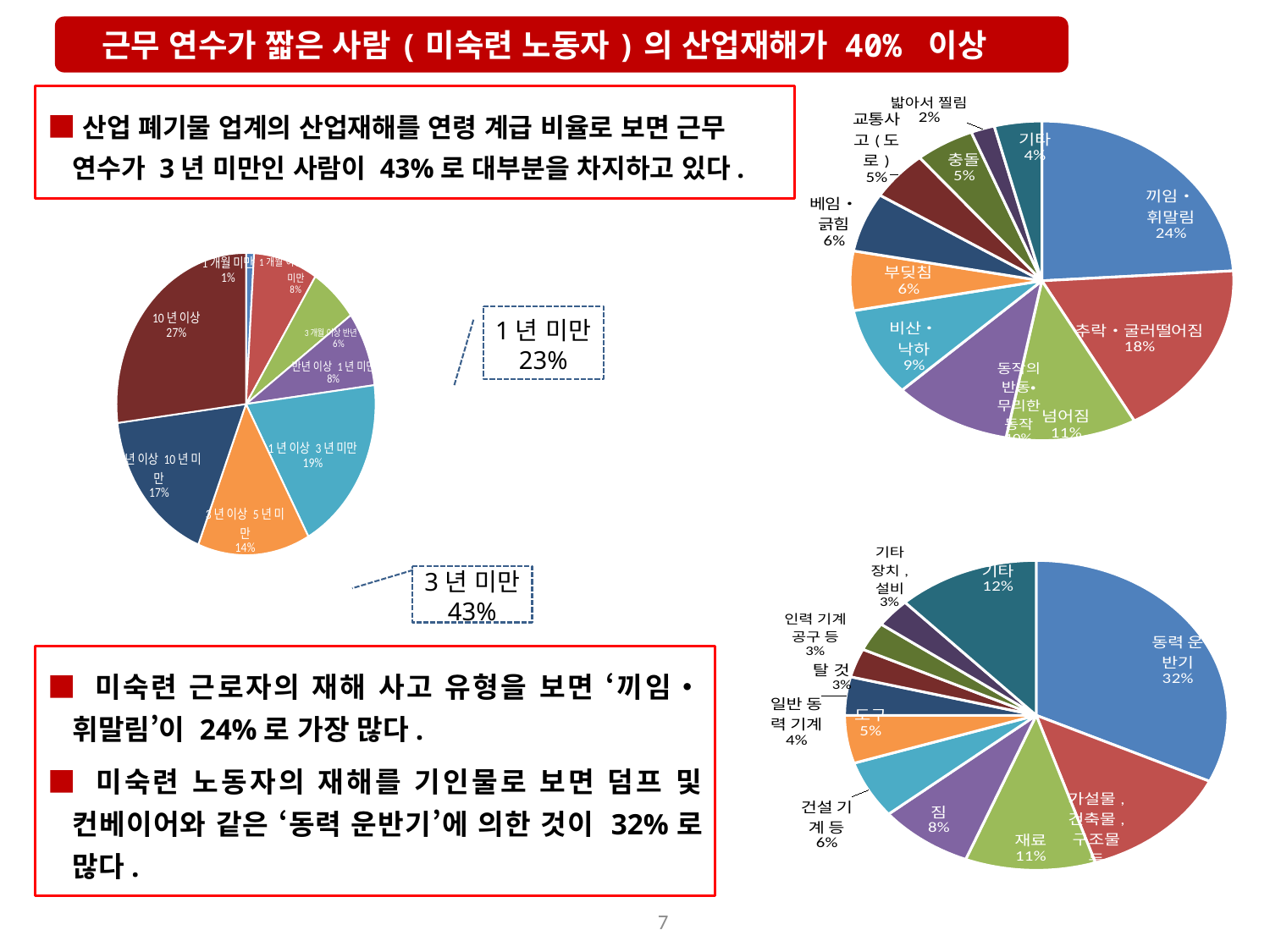
In the top-right pie chart, what share is labelled for 끼임·휘말림? 24% In the bottom-right pie chart, which is larger, the share for 짐 or the share for 건설 기계 등? 짐 What kind of chart is shown at the top right of the slide? Pie chart In the bottom-right pie chart, what share is labelled for 동력 운반기? 32% In the bottom-right pie chart, what share is labelled for 재료? 11% In the left pie chart, what is the difference between the shares for 5년 이상 10년 미만 and 3년 이상 5년 미만? 3% In the top-right pie chart, what share is labelled for 추락·굴러떨어짐? 18% In the top-right pie chart, which category has the largest share? 끼임·휘말림 In the top-right pie chart, what is the difference between the shares for 끼임·휘말림 and 넘어짐? 13% In the left pie chart, what share is labelled for 1년 이상 3년 미만? 19% In the left pie chart, what share is labelled for 10년 이상? 27% In the top-right pie chart, which category has the smallest share? 밟아서 찔림